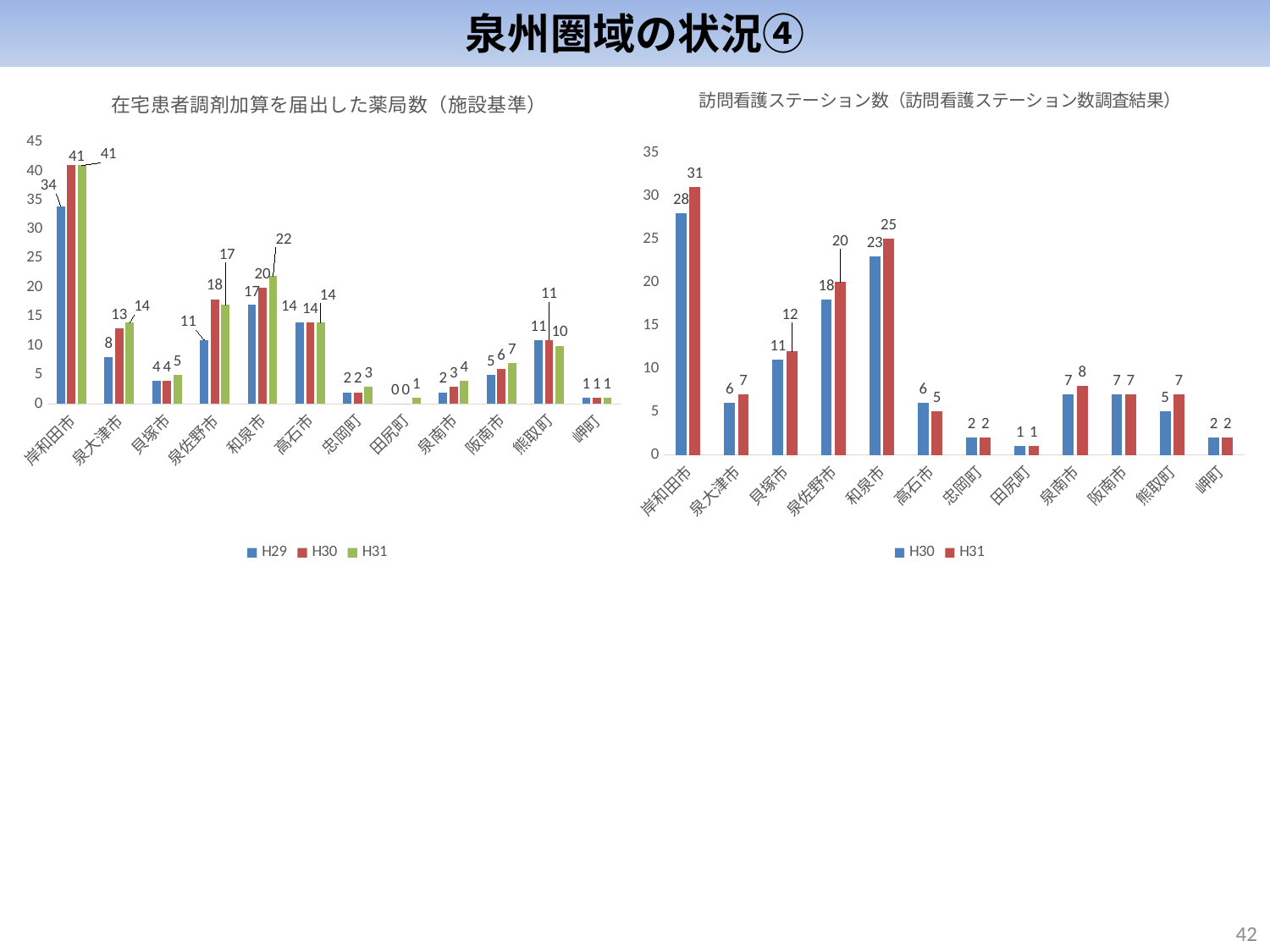
In the left chart (在宅患者調剤加算を届出した薬局数), which category has the highest H30 value? 岸和田市 In the right chart (訪問看護ステーション数), what is the H31 value for 岸和田市? 31 In the left chart (在宅患者調剤加算を届出した薬局数), how many series does the legend list? 3 In the left chart (在宅患者調剤加算を届出した薬局数), what is the difference between the H30 and H29 values for 泉佐野市? 7 In the right chart (訪問看護ステーション数), what is the H30 value for 泉佐野市? 18 What type of chart is the right chart (訪問看護ステーション数)? Bar chart In the right chart (訪問看護ステーション数), which is larger for 高石市, the H30 value or the H31 value? H30 In the right chart (訪問看護ステーション数), which category has the lowest H31 value? 田尻町 In the left chart (在宅患者調剤加算を届出した薬局数), what is the H31 value for 和泉市? 22 In the right chart (訪問看護ステーション数), what is the difference between the H31 and H30 values for 熊取町? 2 In the left chart (在宅患者調剤加算を届出した薬局数), how many categories are shown on the x axis? 12 In the left chart (在宅患者調剤加算を届出した薬局数), what is the H29 value for 岸和田市? 34